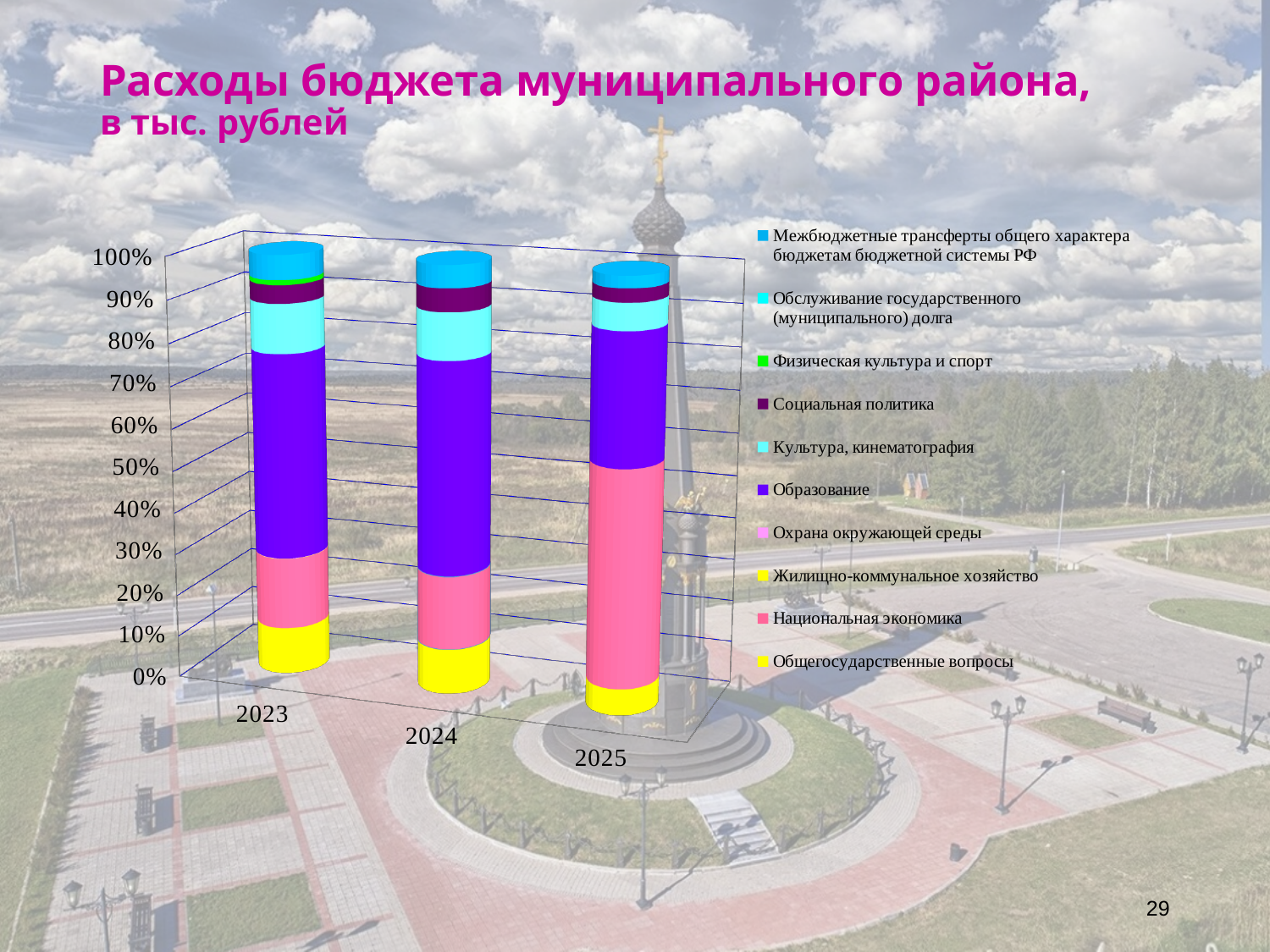
In which year is the share of Образование the smallest? 2025 Which year has the larger share of Национальная экономика, 2023 or 2025? 2025 Does the share of Образование rise or fall from 2023 to 2025? Falls How many series does the chart legend list? 10 Does the share of Национальная экономика rise or fall from 2023 to 2025? Rises Is the share of Национальная экономика in 2023 greater or less than 30%? less What kind of chart is shown on the slide? Stacked bar chart Is the share of Образование in 2023 greater or less than 40%? greater What is the title of the chart on the slide? Расходы бюджета муниципального района, в тыс. рублей In which year is the share of Национальная экономика the largest? 2025 Which series is shown in yellow at the bottom of each bar? Общегосударственные вопросы How many years are shown on the x axis of the chart? 3